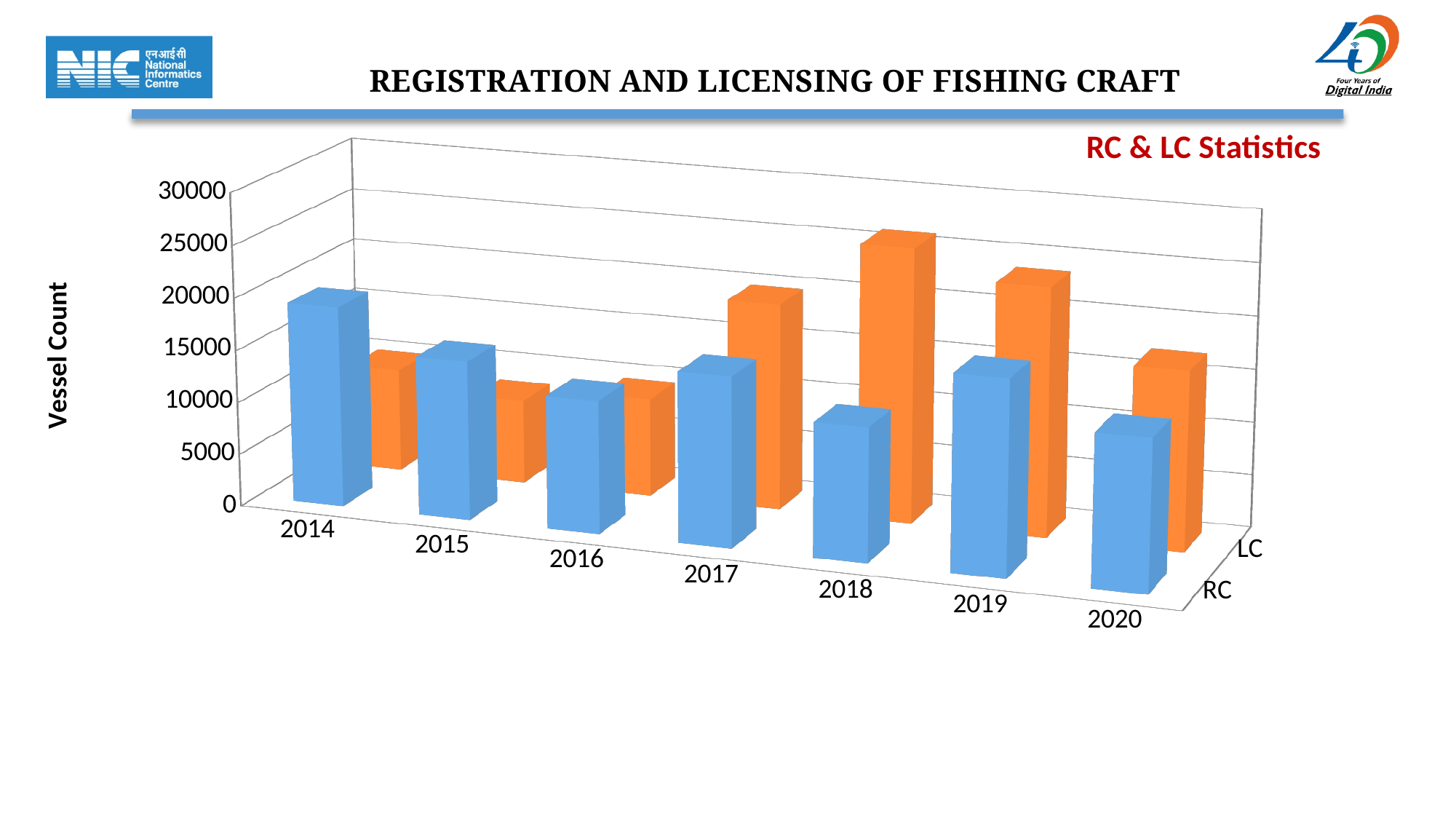
Is the RC value for 2018 greater or less than 20000? less Which colour are the RC bars? blue Is the LC value for 2015 greater or less than 15000? less How many series does the chart plot? 2 What kind of chart is shown on the slide? bar chart How many years are shown along the x axis of the chart? 7 Which year has the highest LC value? 2018 What is the title of the vertical axis? Vessel Count Is the LC value for 2018 greater or less than 20000? greater Which is larger, the RC value for 2014 or the RC value for 2018? 2014 Do the LC values rise or fall from 2016 to 2018? rise